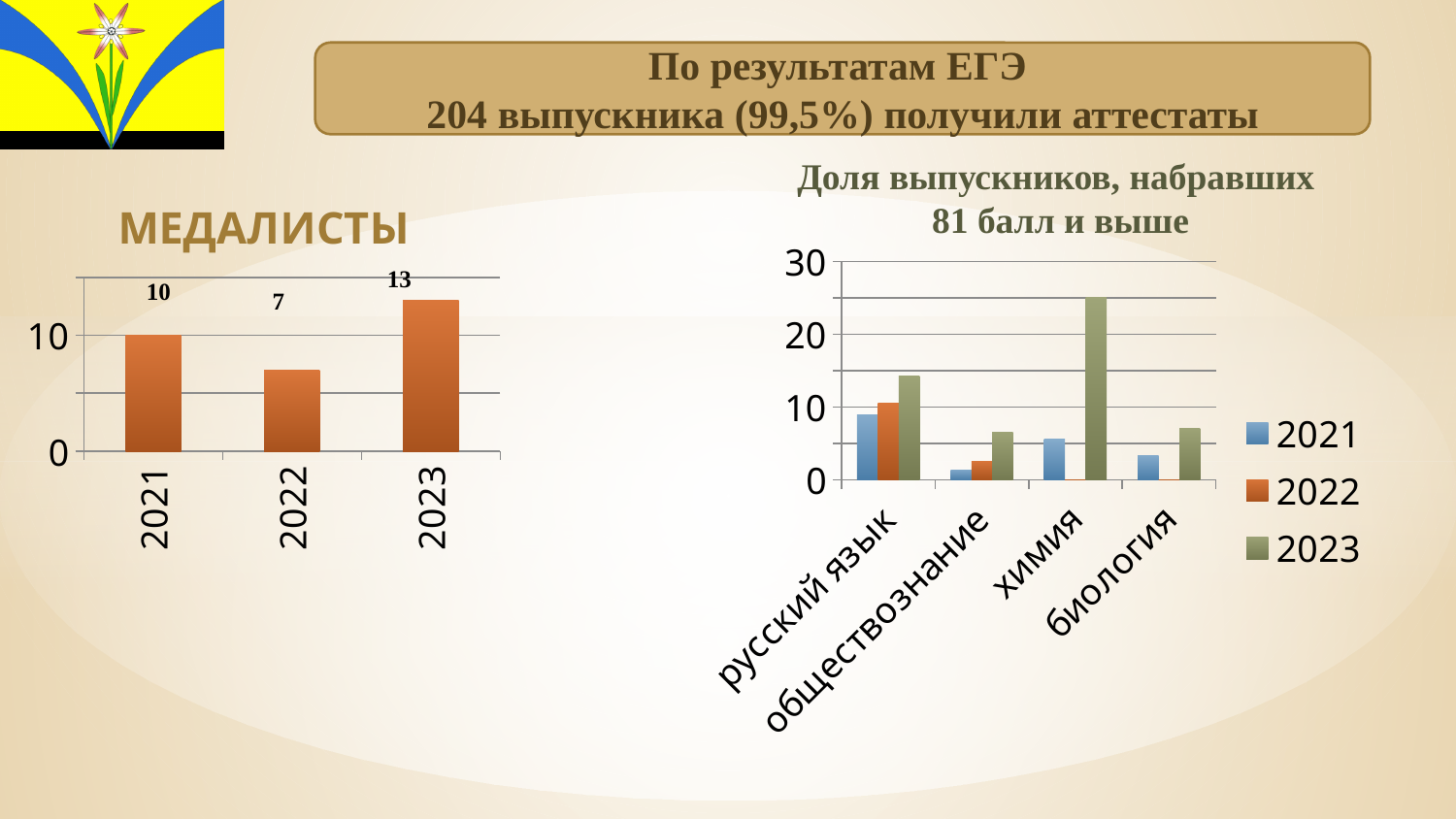
In the chart 'Доля выпускников, набравших 81 балл и выше', is the 2023 value for химия greater or less than 20? greater In the chart 'Доля выпускников, набравших 81 балл и выше', how many subject categories are shown? 4 What kind of chart is the МЕДАЛИСТЫ chart? bar chart In the chart 'Доля выпускников, набравших 81 балл и выше', how many series does the legend list? 3 In the МЕДАЛИСТЫ chart, what is the value for 2021? 10 In the chart 'Доля выпускников, набравших 81 балл и выше', which subject has the highest 2023 value? химия In the МЕДАЛИСТЫ chart, what is the difference between the values for 2023 and 2022? 6 In the МЕДАЛИСТЫ chart, which year has the lowest value? 2022 In the МЕДАЛИСТЫ chart, how many years are shown? 3 In the chart 'Доля выпускников, набравших 81 балл и выше', which is larger for русский язык: the 2021 value or the 2023 value? 2023 In the МЕДАЛИСТЫ chart, what is the value for 2022? 7 In the МЕДАЛИСТЫ chart, which year has the highest value? 2023